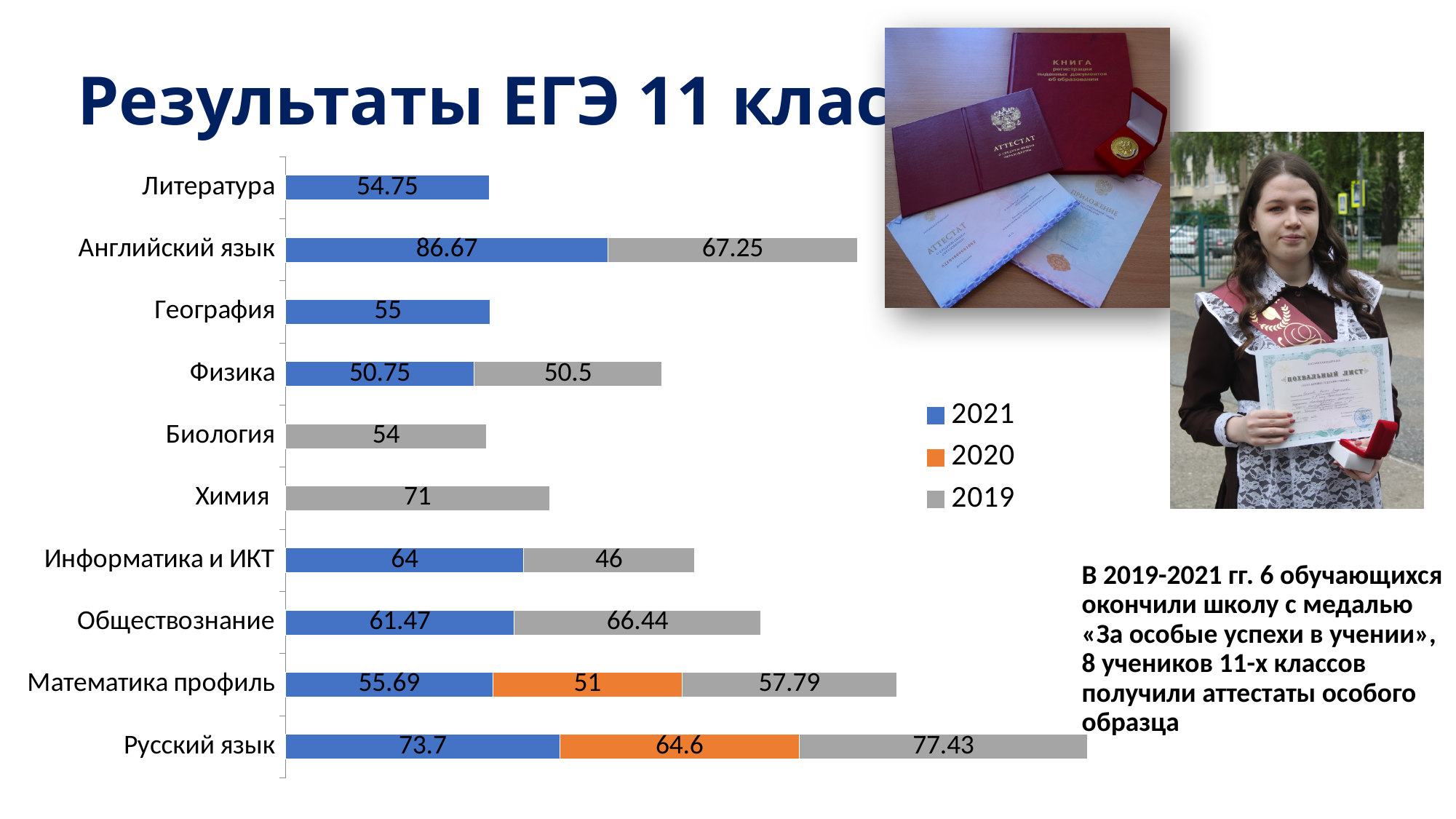
What is the difference between the 2019 and 2021 values for Русский язык? 3.73 What is the 2021 value for Английский язык? 86.67 Which subject has the highest 2021 value? Английский язык Which subject has the lowest 2021 value? Физика What is the total of the stacked bar for Математика профиль? 164.48 How many subject categories are shown in the chart? 10 What is the 2020 value for Русский язык? 64.6 What is the 2019 value for Химия? 71 What type of chart is shown on the slide? Stacked bar chart Which colour represents the 2020 series in the legend? Orange How many series does the chart legend list? 3 For Информатика и ИКТ, which year has the larger value, 2021 or 2019? 2021